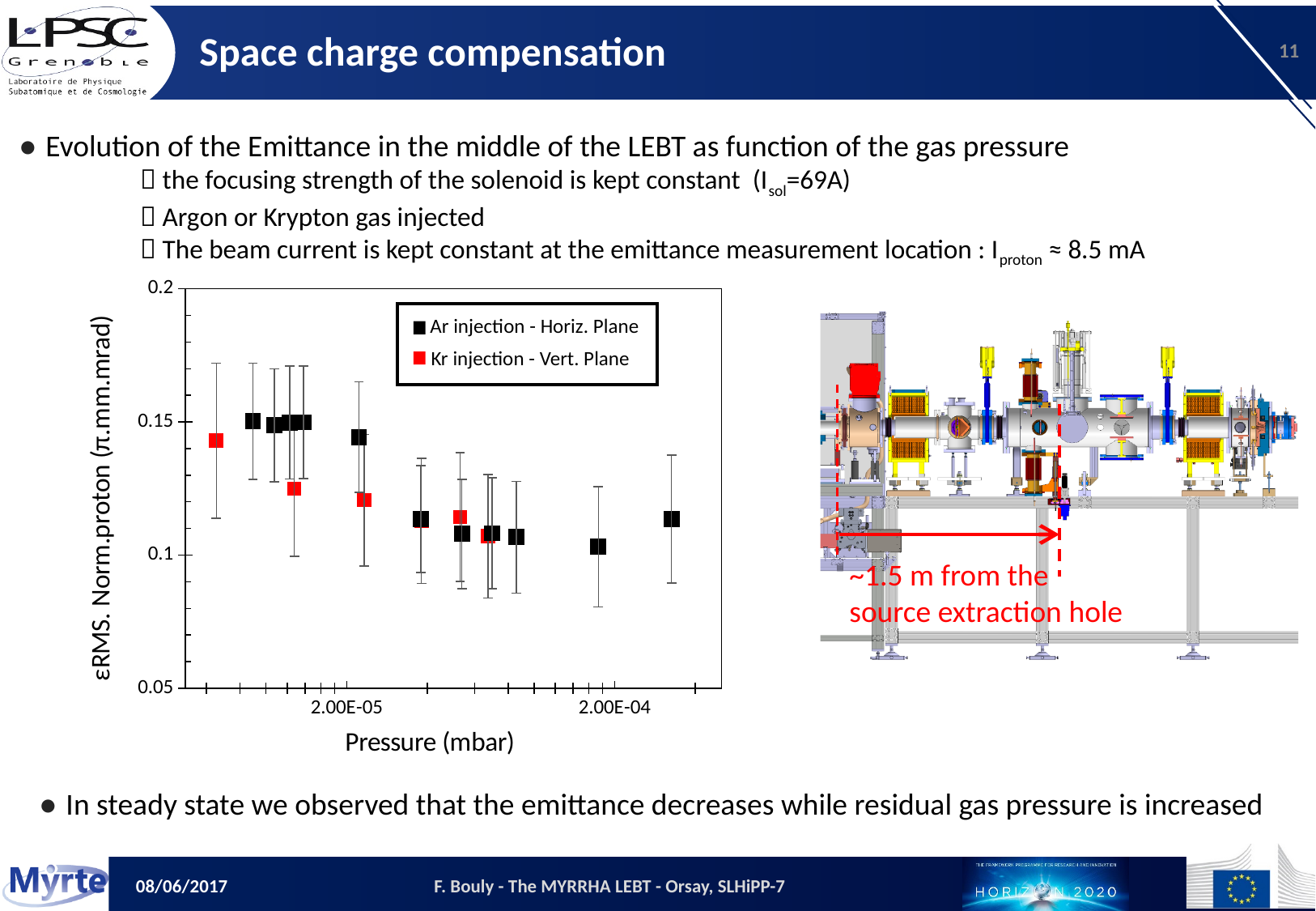
What kind of chart is shown on the slide? Scatter chart Overall, do the emittance values rise or fall as the pressure increases along the x axis? Fall Is the value of the Ar injection - Horiz. Plane point at the lowest pressure greater or less than 0.1? greater What is the title of the x axis of the chart? Pressure (mbar) Is the value of the rightmost Ar injection - Horiz. Plane point greater or less than 0.15? less Is the value of the leftmost Kr injection - Vert. Plane point greater or less than 0.1? greater What is the highest value shown on the y axis of the chart? 0.2 Which series is plotted with red markers? Kr injection - Vert. Plane How many series does the chart legend list? 2 How many data points are plotted for the Kr injection - Vert. Plane series? 5